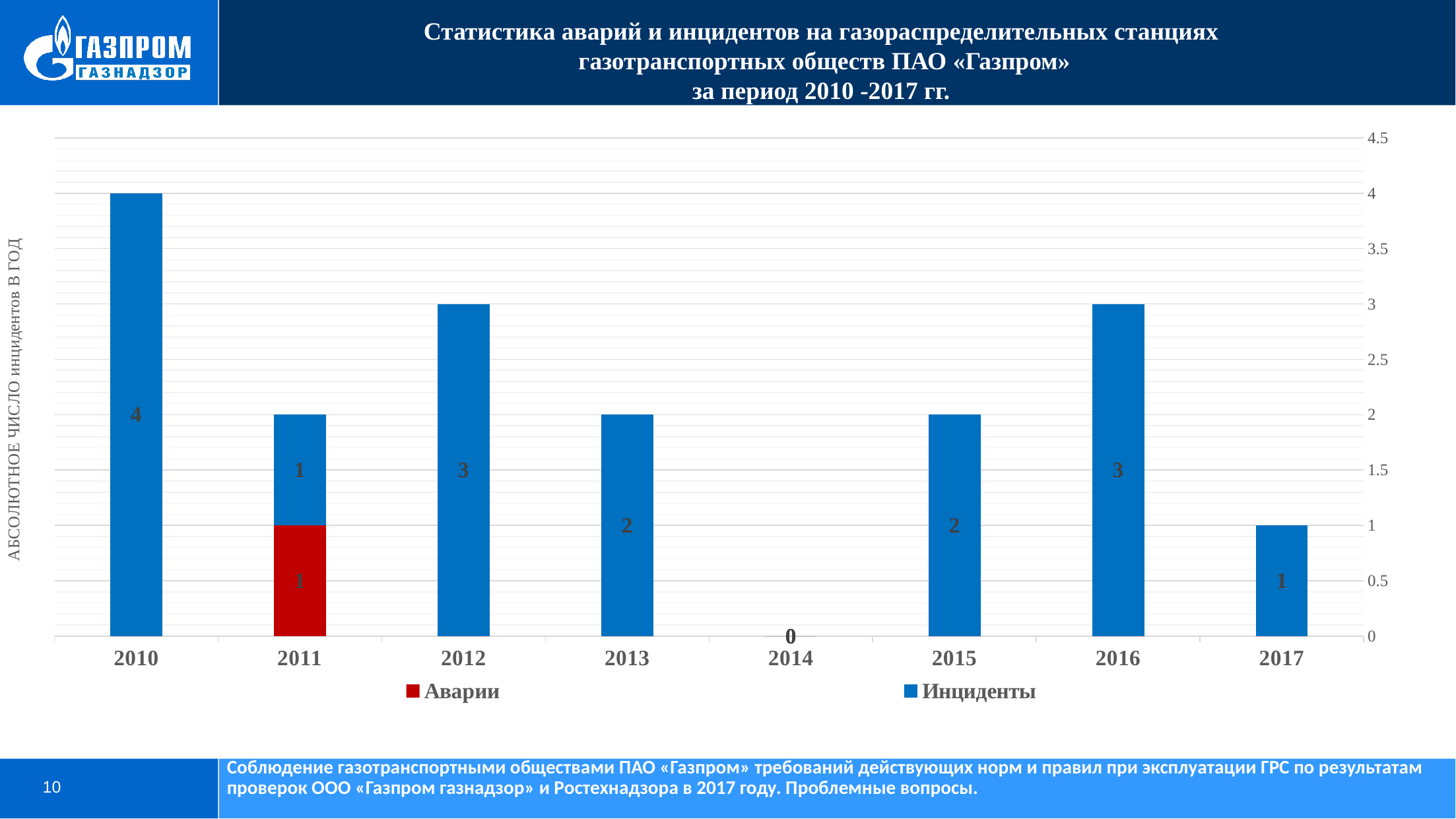
What is the value for Инциденты in 2016? 3 What is the value for Инциденты in 2010? 4 Which year has the highest number of Инциденты? 2010 How many series does the legend list? 2 What is the value shown for 2014? 0 Which is larger, the Инциденты value for 2012 or for 2013? 2012 Which year has the lowest total value? 2014 What is the total of the stacked bar for 2011? 2 What kind of chart is shown on the slide? Bar chart What is the value for Аварии in 2011? 1 What is the difference between the Инциденты values for 2010 and 2017? 3 How many years are shown on the x axis? 8